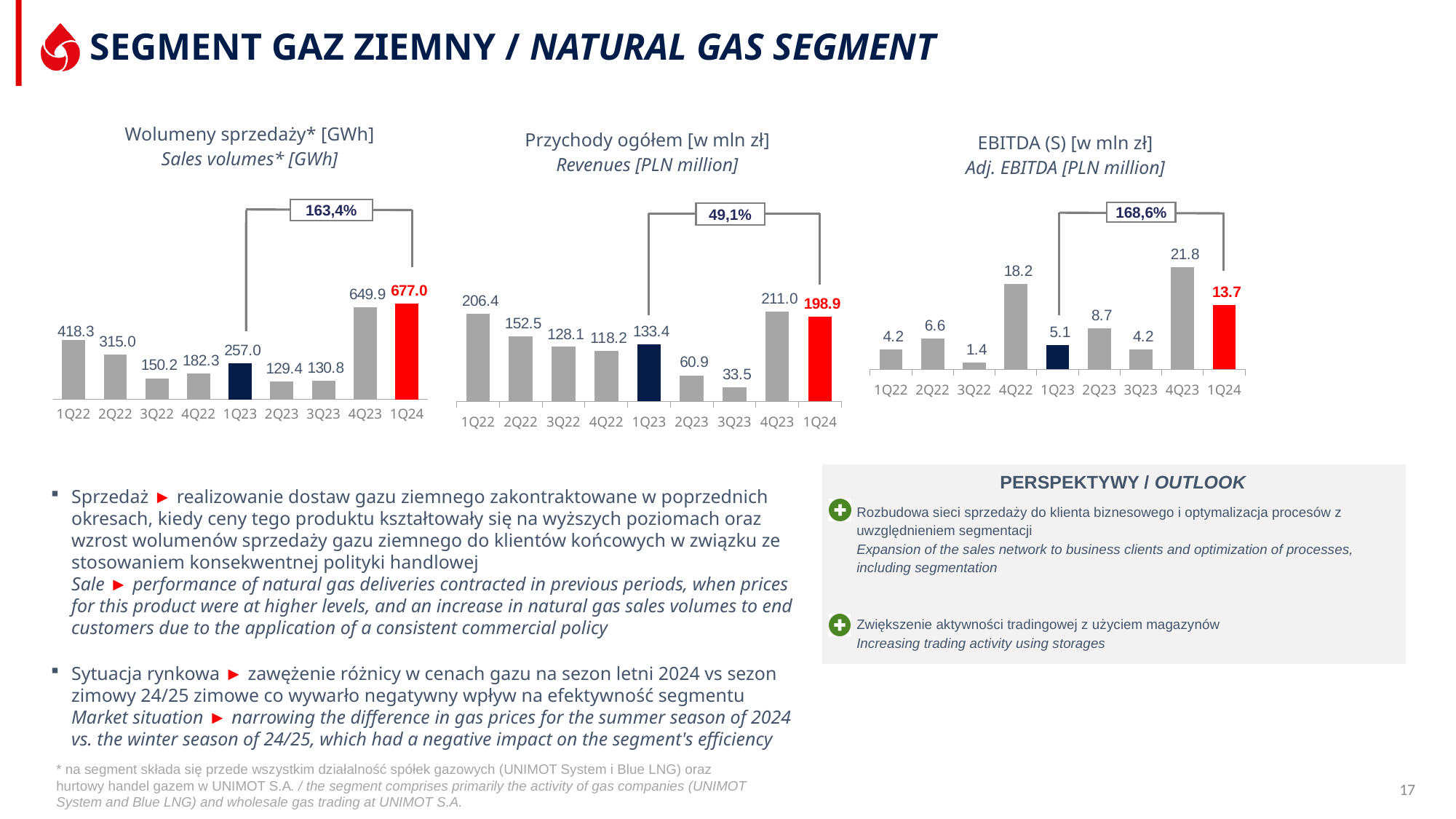
What type of chart is the Adj. EBITDA chart? Bar chart In the Revenues chart, which is larger, 1Q22 or 1Q24? 1Q22 In the Sales volumes chart, what is the difference between 1Q24 and 1Q23? 420.0 What percentage change is shown in the bracket label above the Revenues chart? 49,1% In the Revenues chart, which quarter has the highest value? 4Q23 In the Adj. EBITDA chart, which quarter has the lowest value? 3Q22 In the Revenues chart, what is the value for 3Q23? 33.5 In the Sales volumes chart, which quarter has the lowest value? 2Q23 In the Sales volumes chart, what is the value for 1Q24? 677.0 How many quarters are shown in the Revenues chart? 9 In the Adj. EBITDA chart, what is the value for 4Q22? 18.2 In the Adj. EBITDA chart, what is the difference between 1Q24 and 1Q23? 8.6